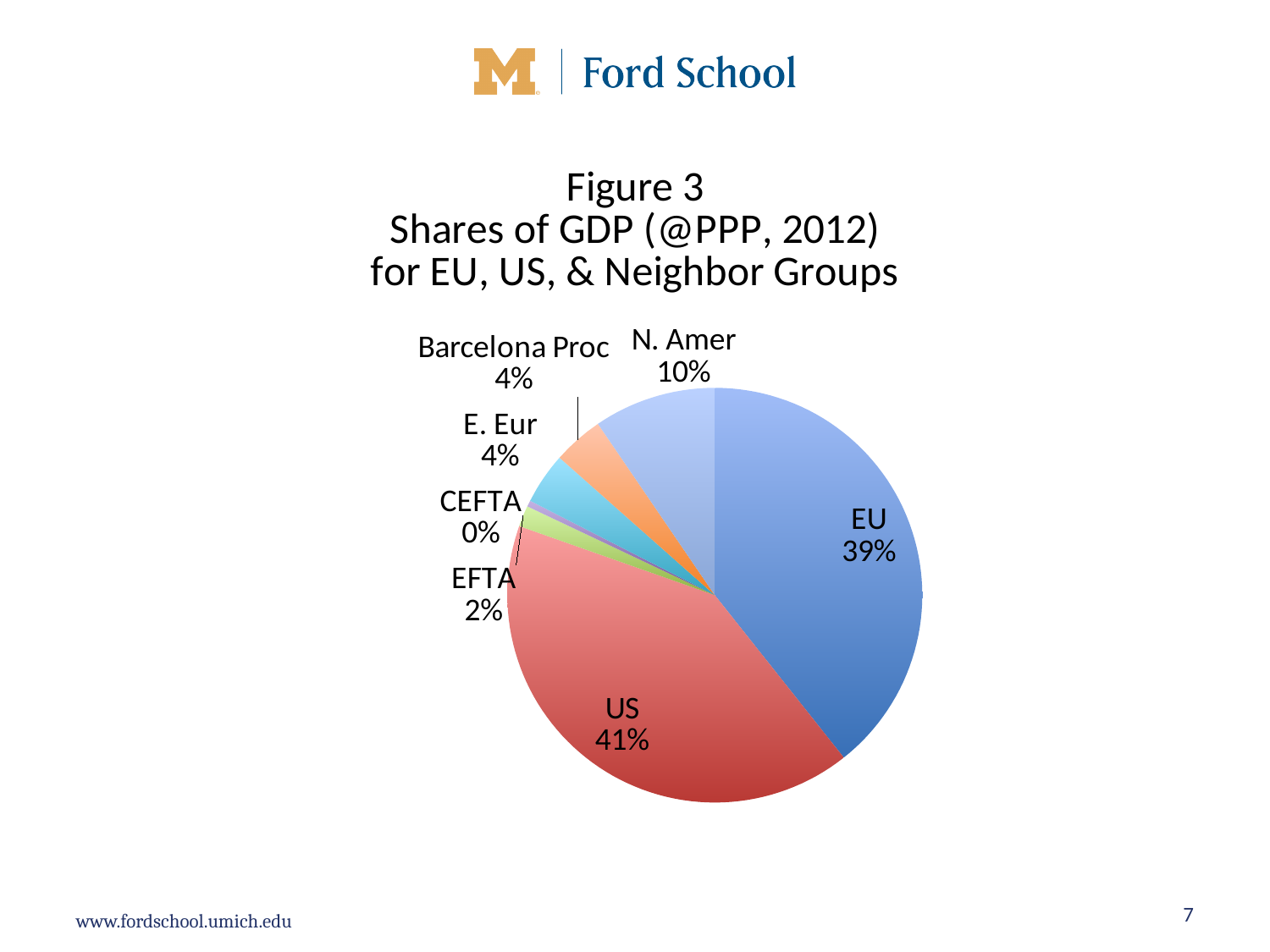
Which group has the smallest share of GDP in the pie chart? CEFTA What share of GDP does the US slice represent? 41% What share is shown for N. Amer? 10% What share is shown for CEFTA? 0% What share of GDP does the EU slice represent? 39% How many percentage points larger is the US share than the EU share? 2 What share is shown for EFTA? 2% What year is given in the chart title? 2012 How many slices does the pie chart have? 7 Which group has the largest share of GDP in the pie chart? US Which is larger, the share for N. Amer or the share for E. Eur? N. Amer What kind of chart is shown on the slide? pie chart